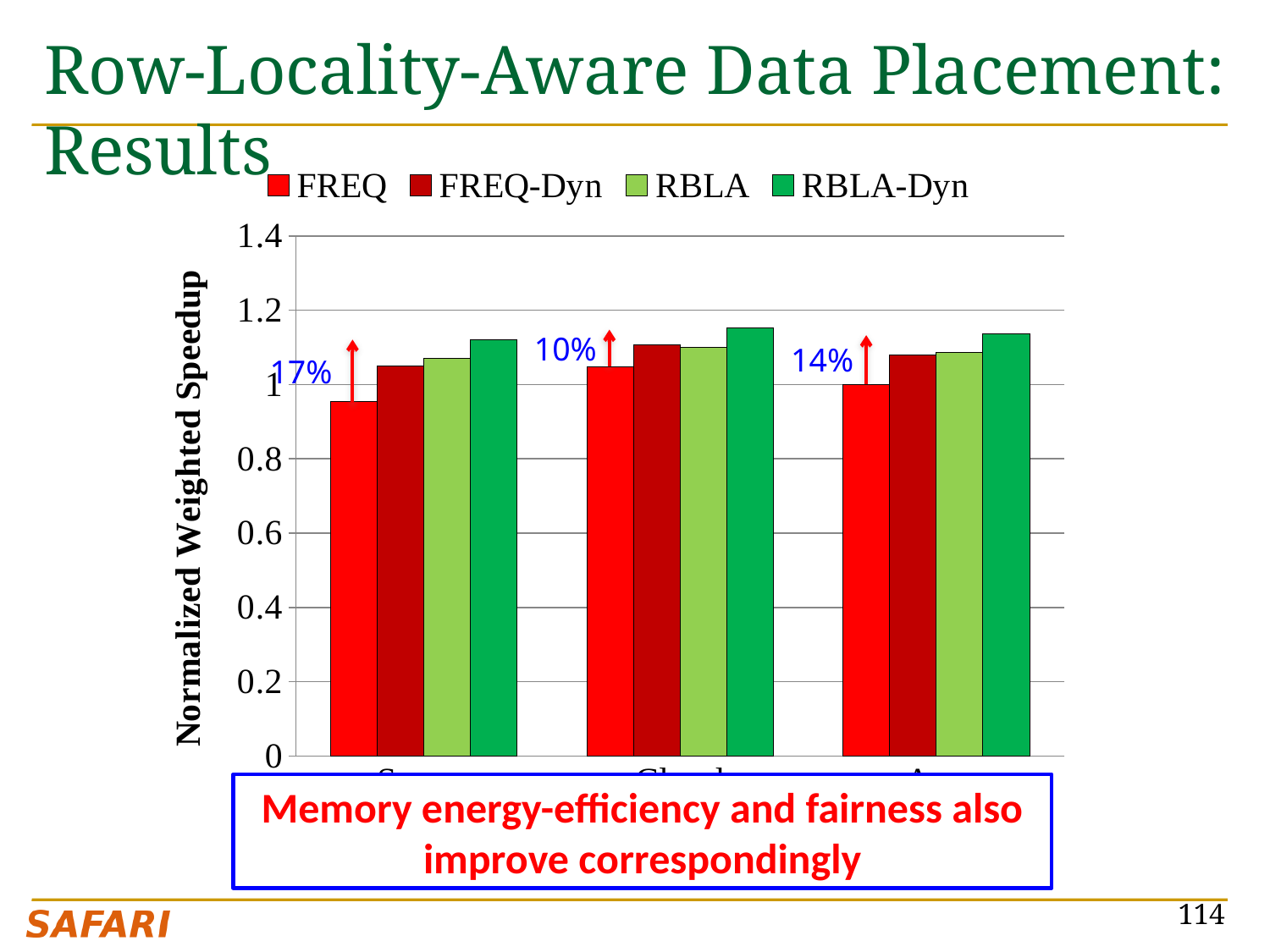
Is the FREQ value in the first (leftmost) group of bars greater or less than 1? less How many series does the legend list? 4 Which series is listed first in the legend? FREQ In the first (leftmost) group of bars, which is larger: FREQ or RBLA-Dyn? RBLA-Dyn In the first (leftmost) group of bars, which series has the highest value? RBLA-Dyn What kind of chart is shown on the slide? bar chart What is the title of the y axis? Normalized Weighted Speedup How many groups of bars are plotted along the x axis? 3 What percentage improvement is annotated above the first (leftmost) group of bars? 17% Is the RBLA-Dyn value in the second (middle) group of bars greater or less than 1.2? less Is the RBLA-Dyn value in the first (leftmost) group of bars greater or less than 1? greater In the first (leftmost) group of bars, which series has the lowest value? FREQ